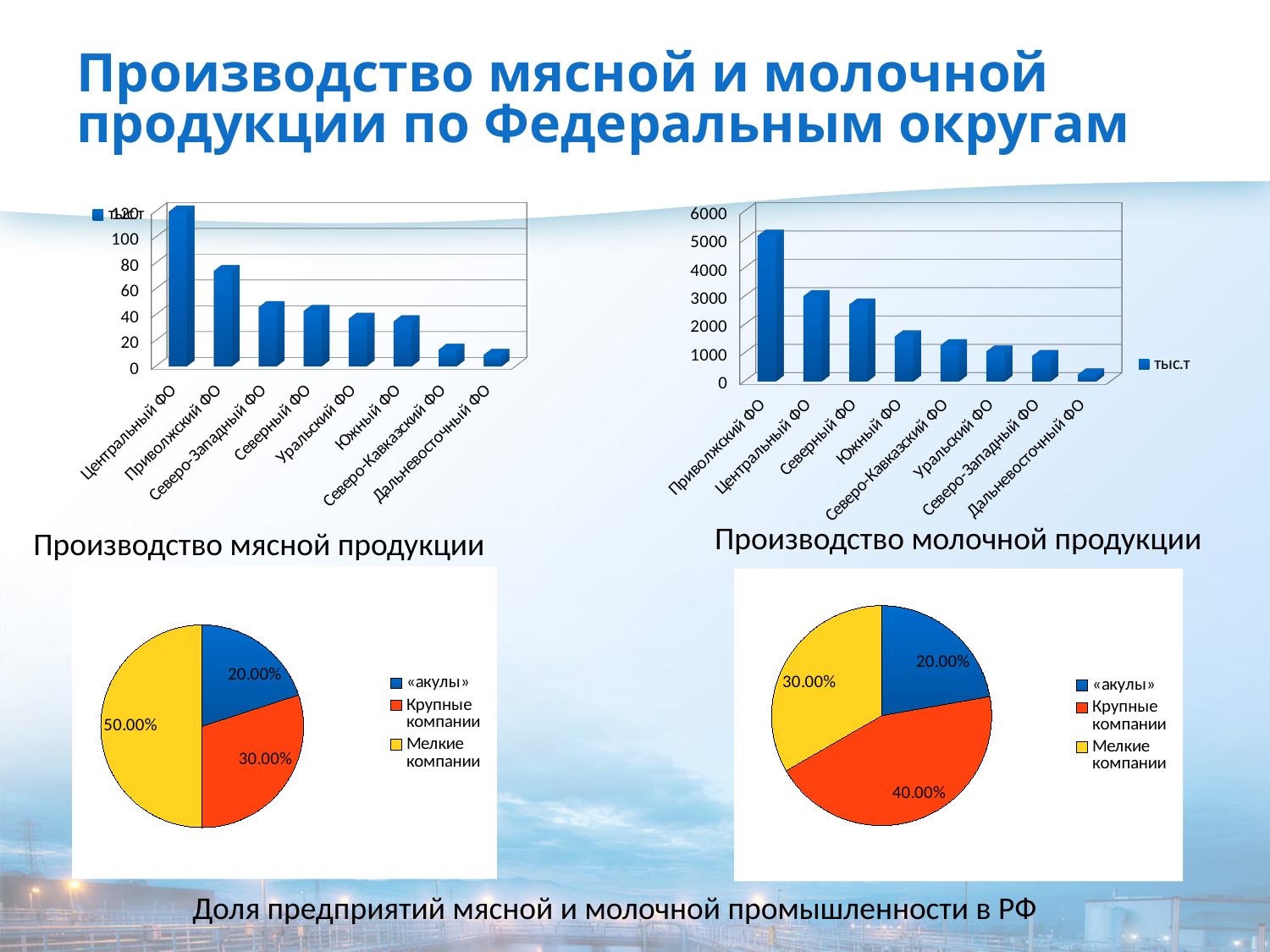
In the top-right bar chart (Производство молочной продукции), which is larger: the value for Южный ФО or the value for Дальневосточный ФО? Южный ФО In the bottom-left pie chart (meat industry share), what share do Мелкие компании have? 50.00% In the top-right bar chart (Производство молочной продукции), which federal district has the highest value? Приволжский ФО In the top-left bar chart (Производство мясной продукции), which federal district has the lowest value? Дальневосточный ФО In the top-left bar chart (Производство мясной продукции), which federal district has the highest value? Центральный ФО How many entries does the legend of the bottom-right pie chart (dairy industry share) list? 3 In the bottom-left pie chart (meat industry share), what is the value for Крупные компании? 30.00% In the bottom-right pie chart (dairy industry share), which category has the largest share? Крупные компании What type of chart is the top-right chart (Производство молочной продукции)? bar chart How many federal districts are shown in the top-left bar chart (Производство мясной продукции)? 8 In the top-left bar chart (Производство мясной продукции), is the value for Приволжский ФО greater or less than 60? greater In the top-right bar chart (Производство молочной продукции), is the value for Приволжский ФО greater or less than 5000? greater